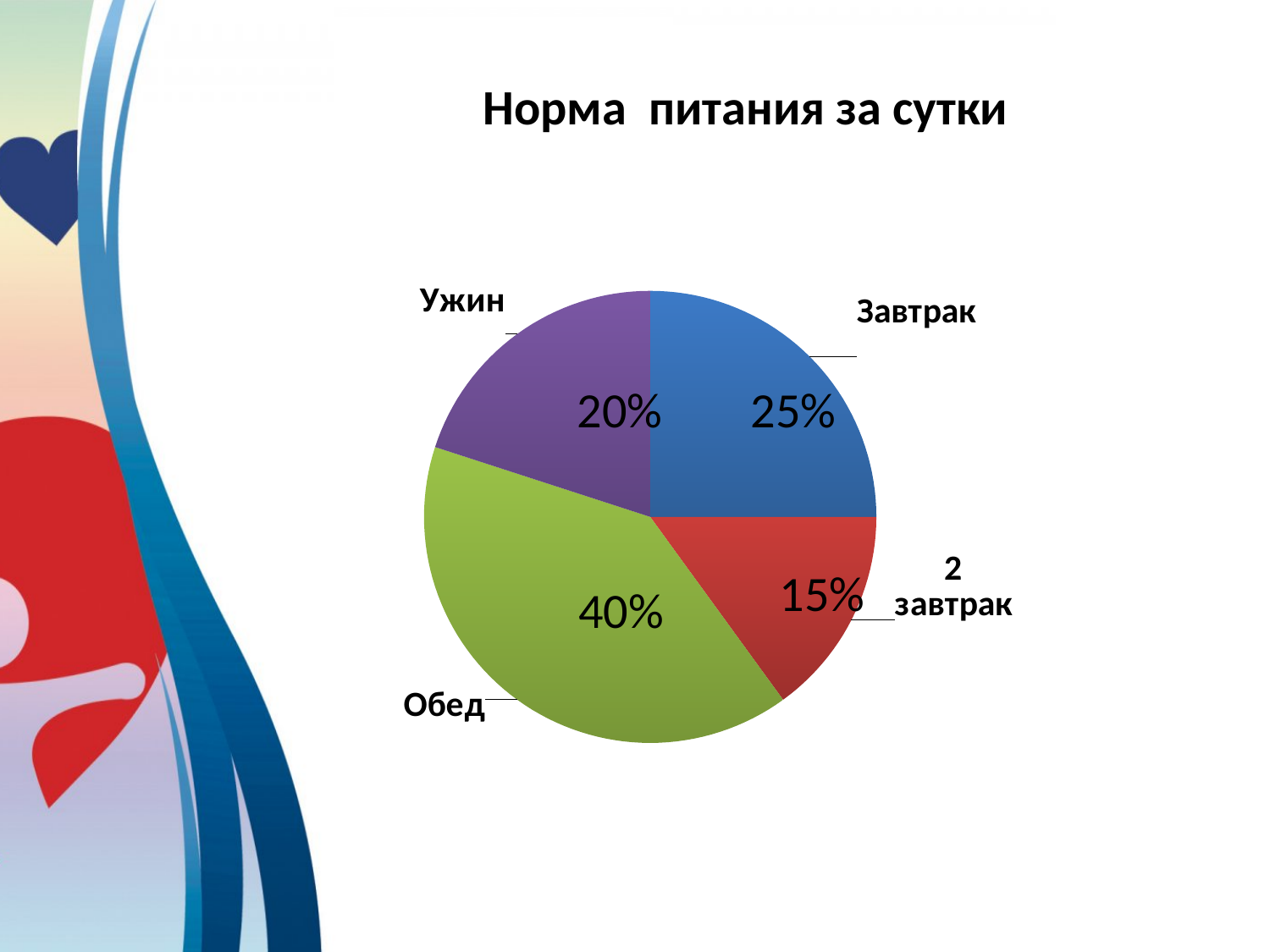
What share of the pie does Завтрак take? 25% Which is larger, the share of Ужин or the share of 2 завтрак? Ужин What share of the pie does Обед take? 40% Which category has the smallest slice of the pie? 2 завтрак What colour is the Обед slice? green What type of chart is shown on the slide? pie chart What share of the pie does Ужин take? 20% How many slices does the pie chart have? 4 What share of the pie does 2 завтрак take? 15% What is the title of the chart? Норма питания за сутки What is the difference between the shares of Обед and Завтрак? 15% Which category has the largest slice of the pie? Обед